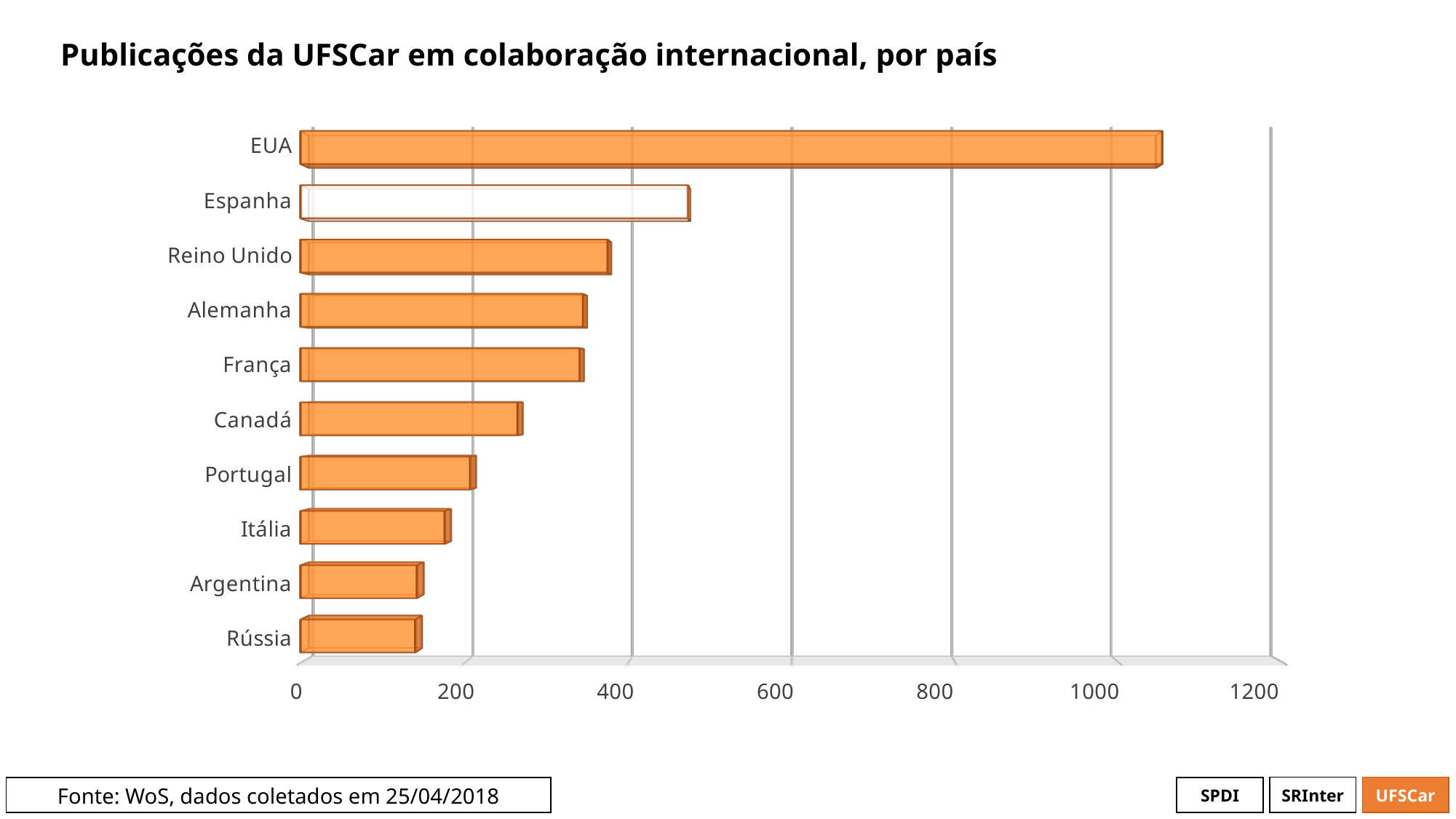
Which has more publications, Canadá or Portugal? Canadá What is the title of the chart? Publicações da UFSCar em colaboração internacional, por país Is the value for Itália greater or less than 200? less Is the value for Espanha greater or less than 400? greater Is the value for Reino Unido greater or less than 400? less Which has more publications, Espanha or Reino Unido? Espanha How many countries are shown in the chart? 10 Which country has the highest number of publications in international collaboration? EUA What kind of chart is shown on the slide? bar chart Which country's bar is drawn in white instead of orange? Espanha